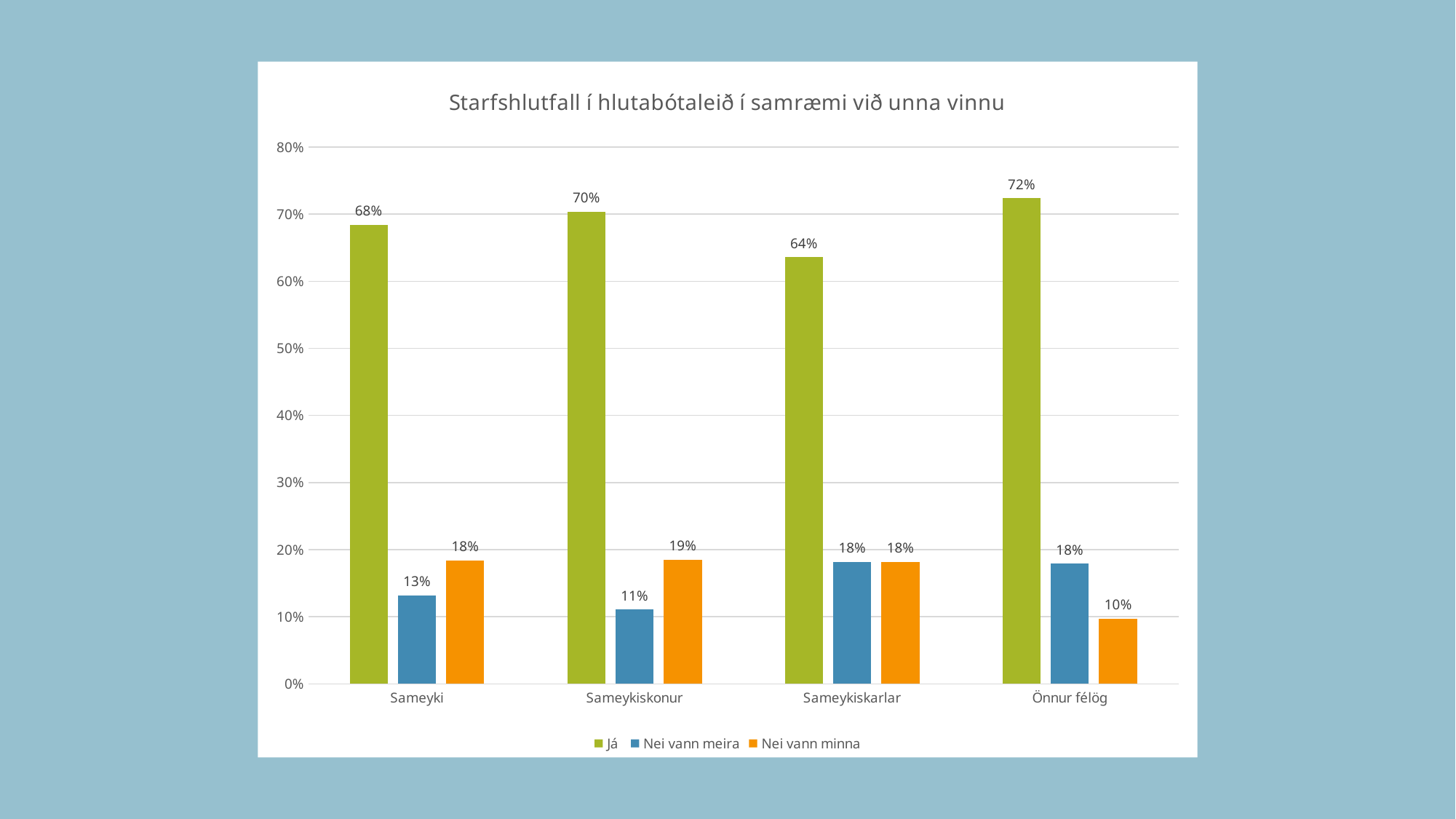
Which is larger: 'Nei vann meira' for Sameyki or 'Nei vann meira' for Sameykiskonur? Sameyki What is the title of the chart? Starfshlutfall í hlutabótaleið í samræmi við unna vinnu Is the 'Já' value for Sameykiskarlar greater or less than 60%? greater Which category has the lowest 'Já' value? Sameykiskarlar What is the difference between the 'Já' values for Önnur félög and Sameykiskarlar? 8% How many series does the legend list? 3 What kind of chart is shown on the slide? Bar chart What is the value of 'Nei vann minna' for Önnur félög? 10% How many categories are shown on the x axis? 4 What is the value of 'Nei vann meira' for Sameyki? 13% What is the value of 'Já' for Sameykiskonur? 70% Which category has the highest 'Já' value? Önnur félög